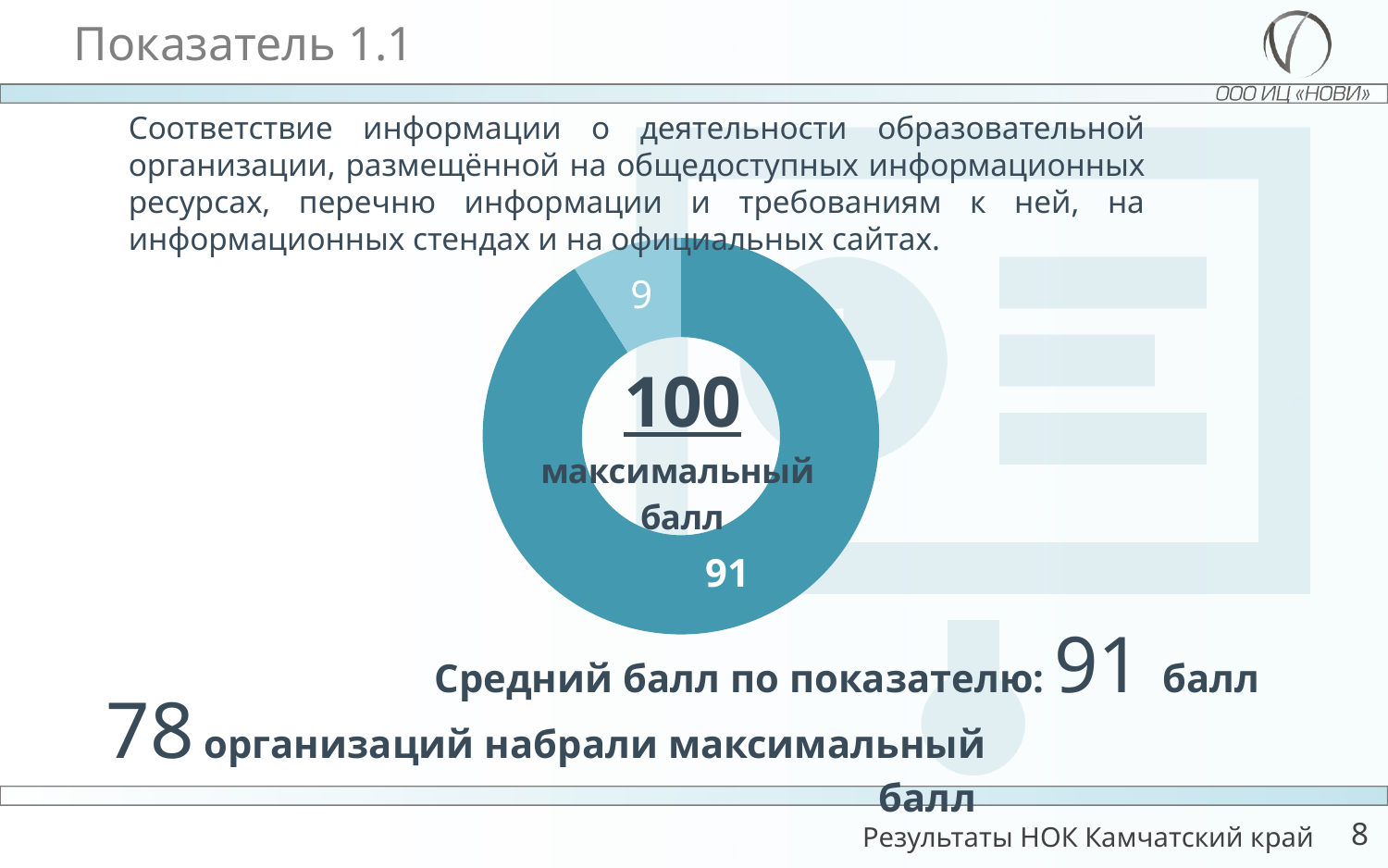
How many slices does the donut chart have? 2 Which slice is larger in the donut chart, the dark teal one or the light teal one? The dark teal one What text accompanies the number in the centre of the donut chart? максимальный балл What is the difference between the two slice values in the donut chart? 82 What value is labelled on the light teal slice of the donut chart? 9 What kind of chart is shown on the slide? Pie chart (donut) What is the value of the largest slice in the donut chart? 91 What value is labelled on the dark teal slice of the donut chart? 91 What number is printed in the centre of the donut chart? 100 What is the total of the two slice values in the donut chart? 100 What is the value of the smallest slice in the donut chart? 9 What share of the donut chart does the slice labelled 91 represent? 91%